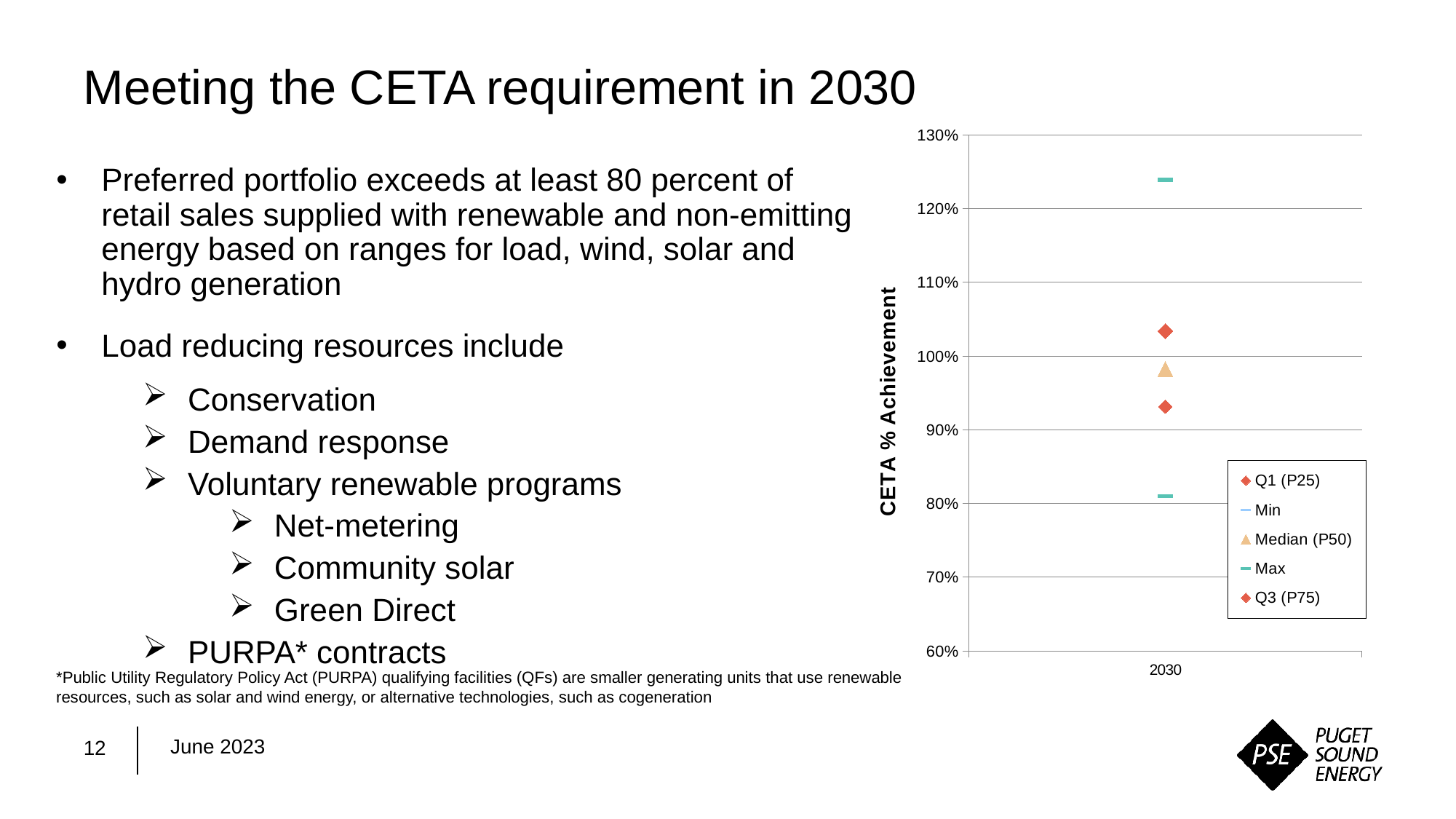
Is the value for Max greater or less than 120%? greater What is the only category shown on the x axis of the chart? 2030 Is the value for Q3 (P75) greater or less than 100%? greater Which series has the lowest value in the chart? Min Which series has the highest value in the chart? Max How many categories are shown on the x axis of the chart? 1 Is the value for Min greater or less than 90%? less Which is larger, the value for Q3 (P75) or the value for Q1 (P25)? Q3 (P75) What is the title of the vertical axis of the chart? CETA % Achievement Which is larger, the value for Median (P50) or the value for Max? Max How many series does the chart legend list? 5